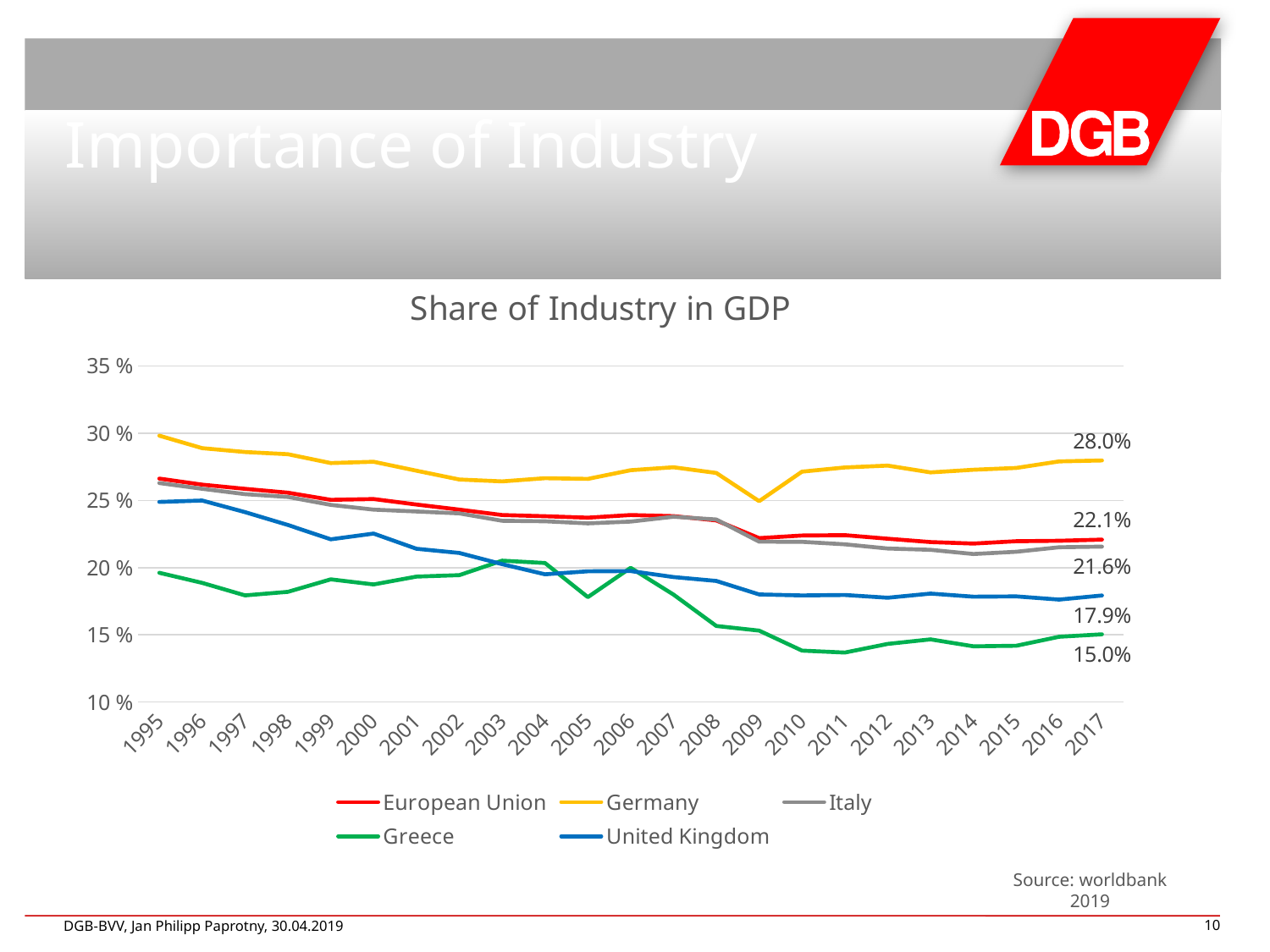
What is the value for Germany in 2017? 28.0% What is the value for Greece in 2017? 15.0% Which series has the lowest value in 2017? Greece Does the Germany line generally rise or fall from 1995 to 2017? fall What is the value for the European Union in 2017? 22.1% How many years are shown on the x axis? 23 What kind of chart is shown on the slide? line chart Is the value for Germany in 1995 greater or less than 25 %? greater What is the title of the chart? Share of Industry in GDP What is the difference between Germany's and the United Kingdom's values in 2017? 10.1% Which series has the highest value in 2017? Germany How many series does the legend list? 5